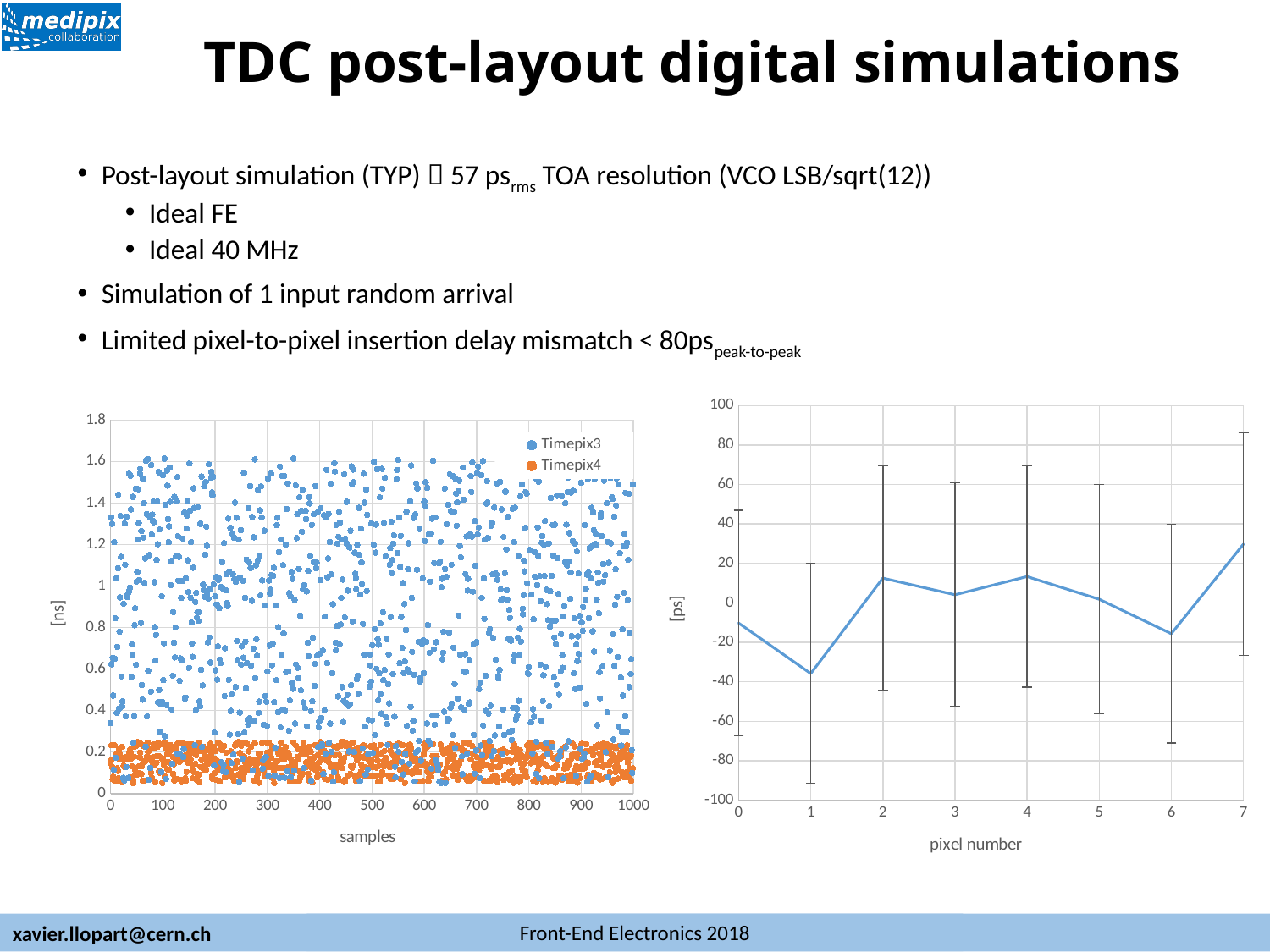
How many pixel numbers are plotted on the right chart? 8 What kind of chart is the chart on the right of the slide? line chart What kind of chart is the chart on the left of the slide? scatter chart What are the two series named in the legend of the left chart? Timepix3 and Timepix4 In the right chart, which pixel number has the lowest value? 1 In the right chart, is the value for pixel number 1 greater or less than -20? less What is the label of the x axis of the left chart? samples In the right chart, does the line rise or fall from pixel number 6 to pixel number 7? rise In the right chart, which pixel number has the highest value? 7 In the left chart, which series has the larger spread of values along the y axis, Timepix3 or Timepix4? Timepix3 In the left chart, are the Timepix4 values greater or less than 0.4 ns? less How many series does the legend of the left chart list? 2